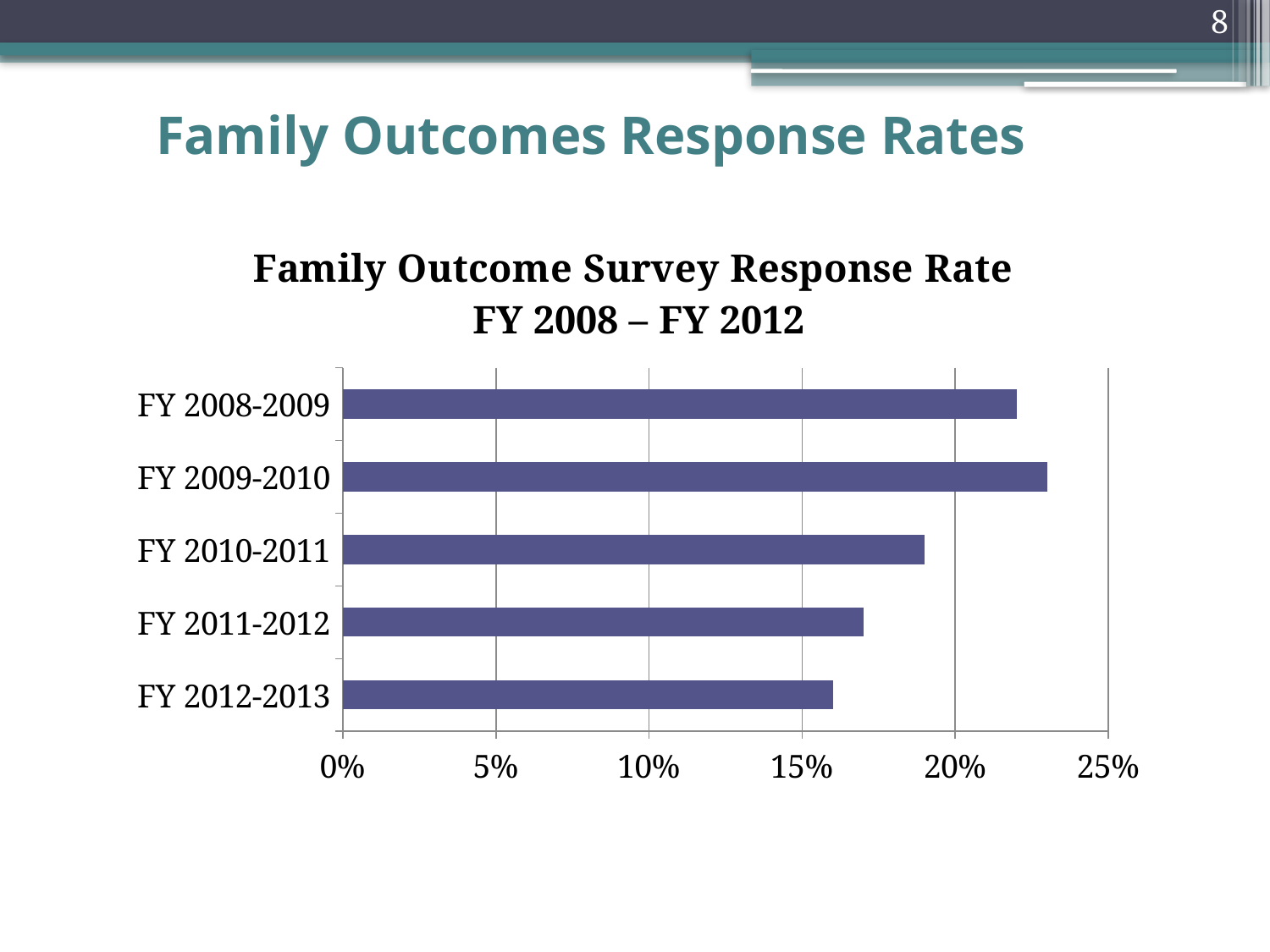
From FY 2009-2010 through FY 2012-2013, do the response rates rise or fall? fall Which fiscal year has the highest response rate? FY 2009-2010 Is the value for FY 2010-2011 greater or less than 20%? less Is the value for FY 2012-2013 greater or less than 20%? less What kind of chart is shown on the slide? bar chart How many fiscal year categories are plotted in the chart? 5 Is the value for FY 2011-2012 greater or less than 15%? greater What is the title of the chart? Family Outcome Survey Response Rate FY 2008 – FY 2012 Which fiscal year has the lowest response rate? FY 2012-2013 Which has the larger response rate, FY 2008-2009 or FY 2011-2012? FY 2008-2009